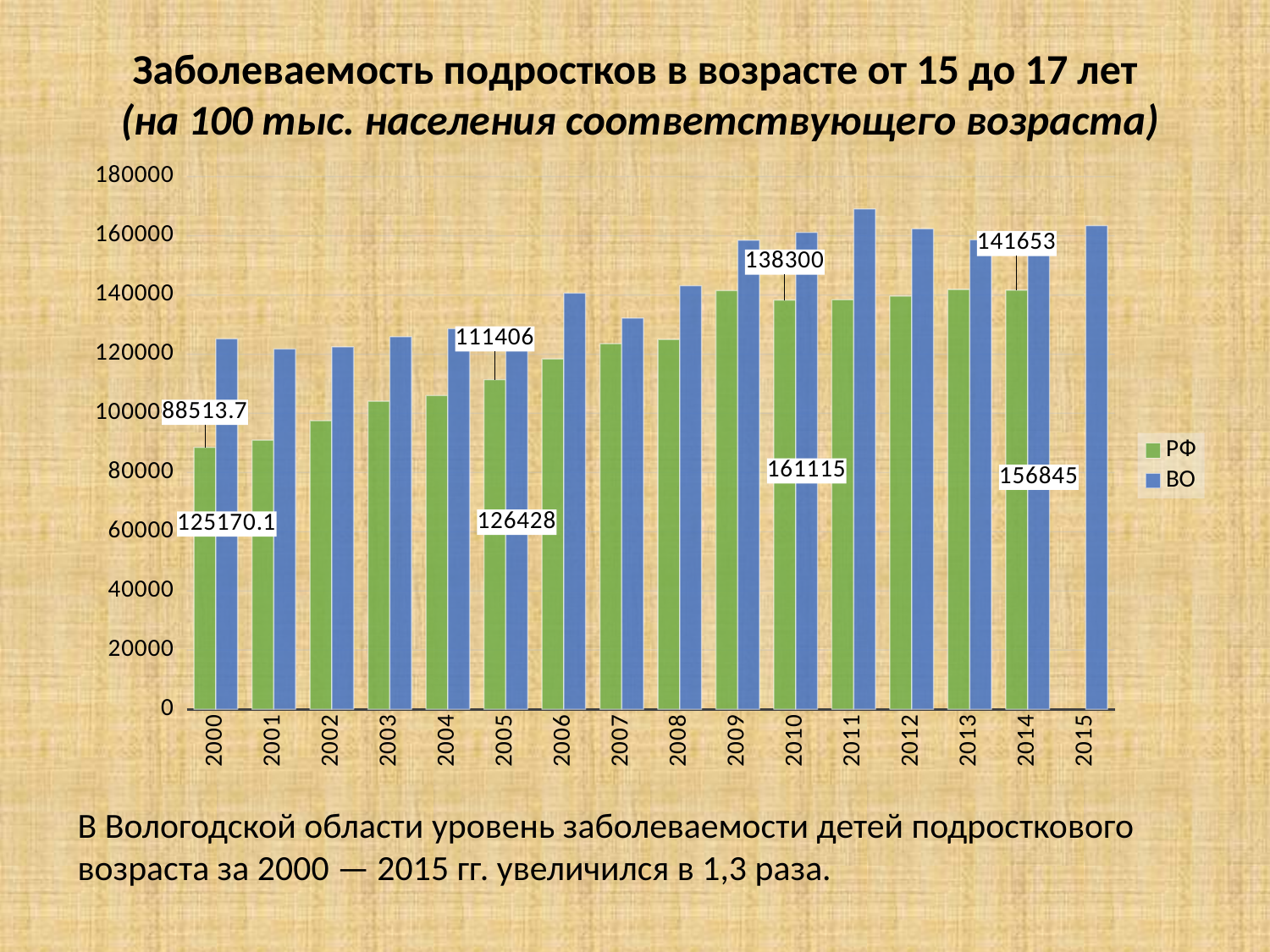
What is the value for ВО in 2005? 126428 How many series does the legend list? 2 What is the value for ВО in 2010? 161115 What is the value for РФ in 2014? 141653 How many years are shown on the x axis? 16 In which year is the ВО value highest? 2011 What type of chart is shown on the slide? bar chart What is the value for РФ in 2000? 88513.7 What is the difference between the ВО and РФ values in 2014? 15192 In which year is the РФ value lowest? 2000 What is the difference between the ВО and РФ values in 2010? 22815 Is the value for ВО in 2011 greater or less than 160000? greater